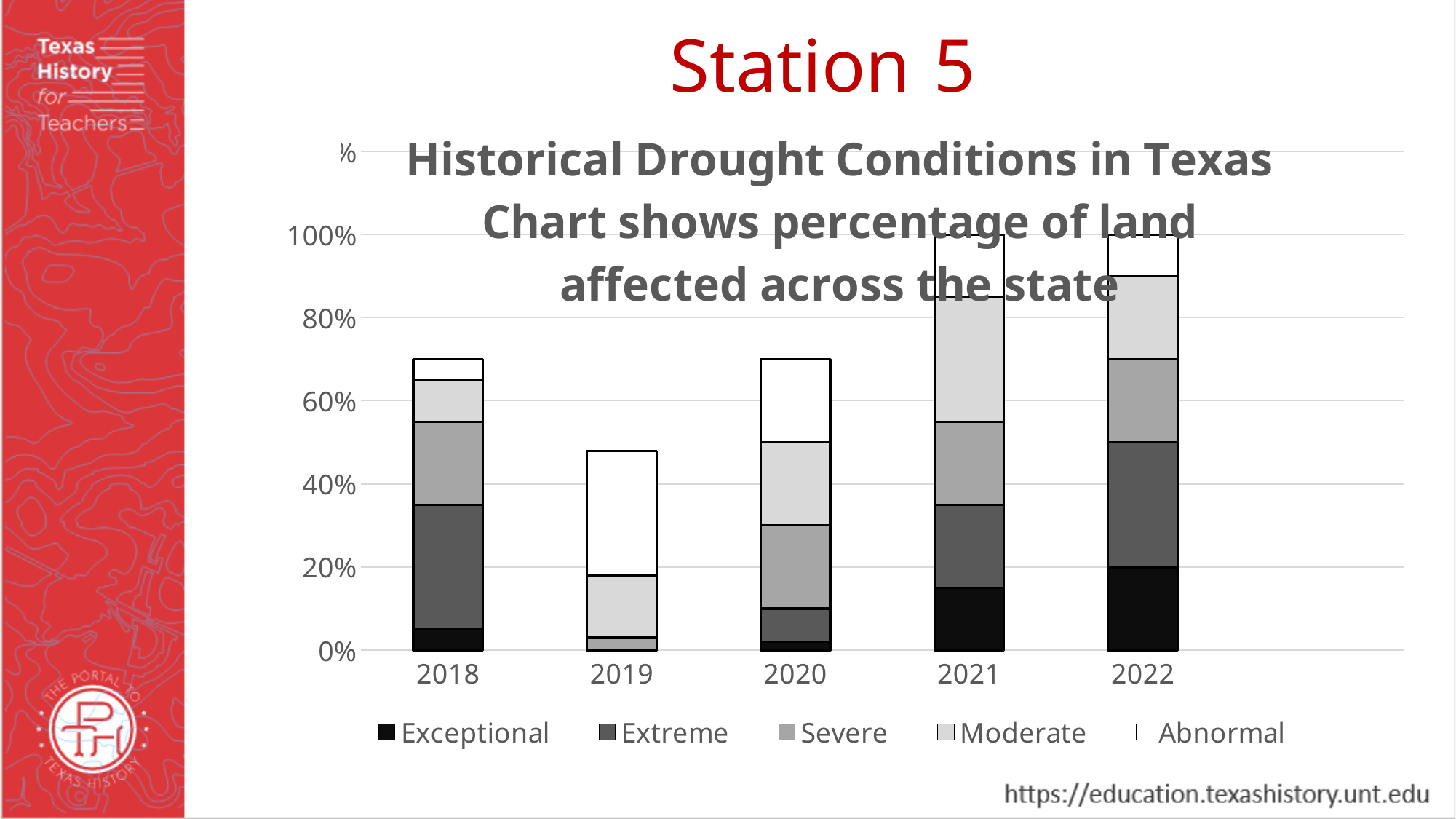
What is the total bar height for 2022? 100% Which year has a taller total bar, 2018 or 2019? 2018 What kind of chart is shown on the slide? stacked bar chart How many series does the chart's legend list? 5 Is the total bar height for 2019 greater or less than 60%? less What is the total bar height for 2021? 100% From 2019 to 2022, do the total bar heights rise or fall? rise Which legend entry is shown in black in the chart? Exceptional How many years are shown on the x axis of the chart? 5 Which year has the lowest total bar height in the chart? 2019 What is the first line of the chart's title? Historical Drought Conditions in Texas Is the total bar height for 2018 greater or less than 60%? greater